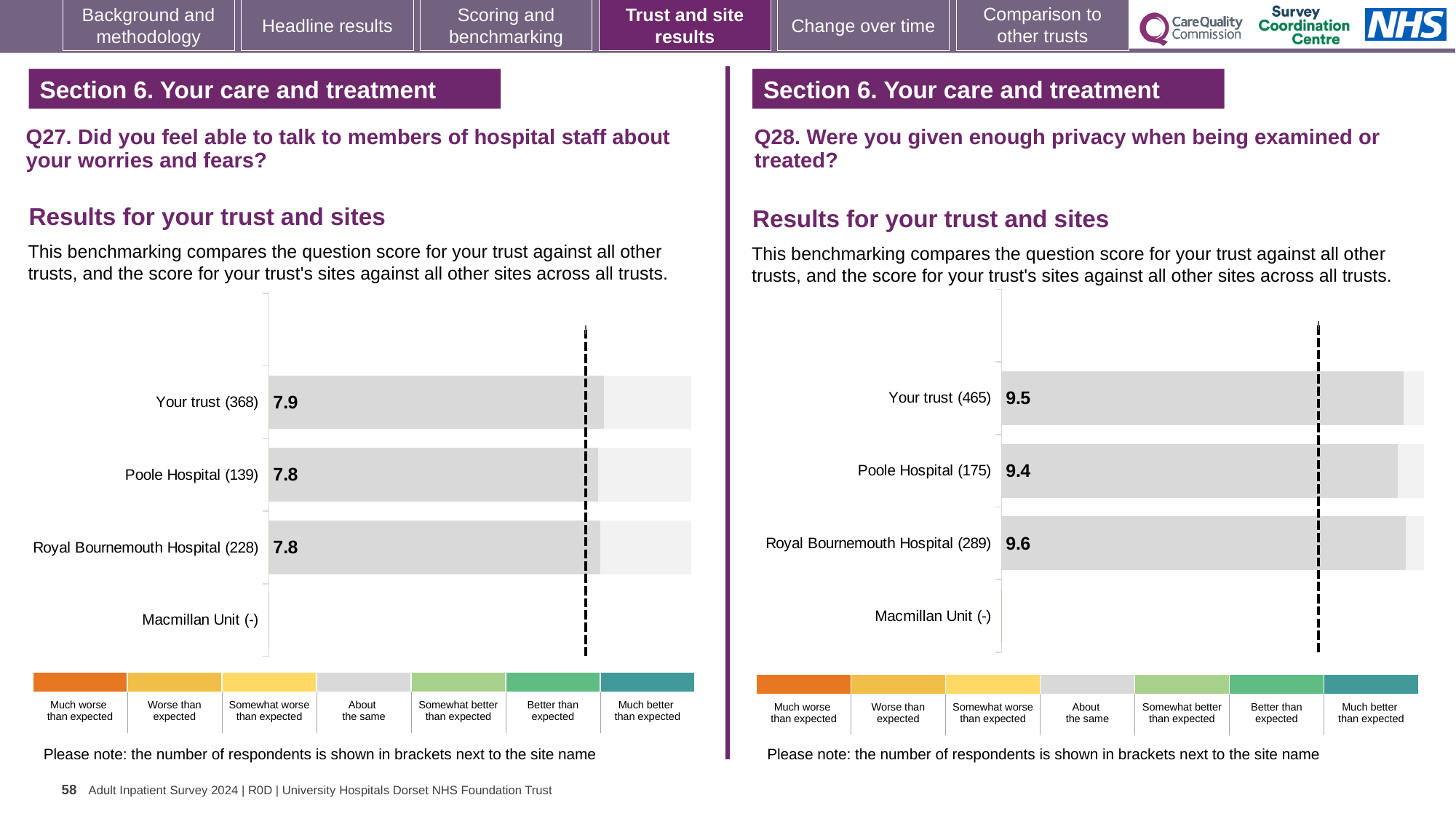
On the Q27 chart (left), what is the score for Your trust? 7.9 On the Q27 chart (left), what is the score for Poole Hospital? 7.8 On the Q27 chart (left), how many respondents are shown in brackets for Royal Bournemouth Hospital? 228 On the Q28 chart (right), what is the score for Royal Bournemouth Hospital? 9.6 What type of chart is used on the Q27 chart (left)? Bar chart On the Q27 chart (left), how many site rows are listed on the vertical axis? 4 On the Q28 chart (right), what is the difference between the score for Royal Bournemouth Hospital and the score for Poole Hospital? 0.2 On the Q28 chart (right), which is larger: the score for Your trust or the score for Poole Hospital? Your trust On the Q27 chart (left), what is the difference between the score for Your trust and the score for Poole Hospital? 0.1 On the Q28 chart (right), which site has the highest score? Royal Bournemouth Hospital On the Q28 chart (right), which site has the lowest score among those with a score shown? Poole Hospital On the Q28 chart (right), what is the score for Poole Hospital? 9.4